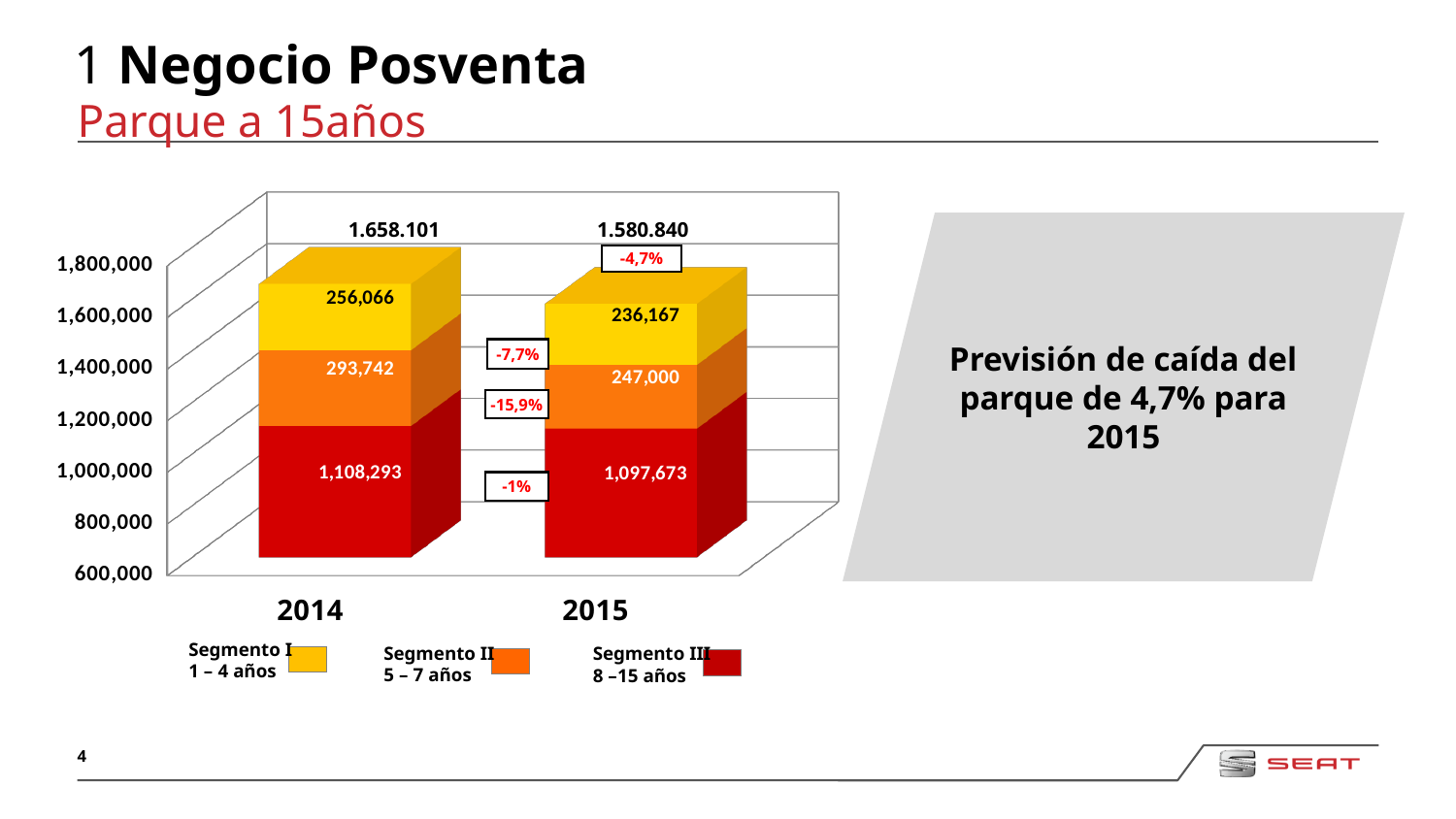
What is the value of Segmento I (1–4 años) for 2015? 236,167 What is the value of Segmento III (8–15 años) for 2014? 1,108,293 What percentage change is shown for Segmento II between 2014 and 2015? -15,9% What is the difference between the Segmento II values for 2014 and 2015? 46,742 Which segment has the largest value in 2015? Segmento III (8–15 años) What is the total shown above the stacked bar for 2014? 1.658.101 How many series does the legend list? 3 Which segment has the smallest value in 2014? Segmento I (1–4 años) Is the Segmento I value larger in 2014 or in 2015? 2014 What kind of chart is shown on the slide? Stacked bar chart What is the value of Segmento II (5–7 años) for 2015? 247,000 What is the total shown above the stacked bar for 2015? 1.580.840